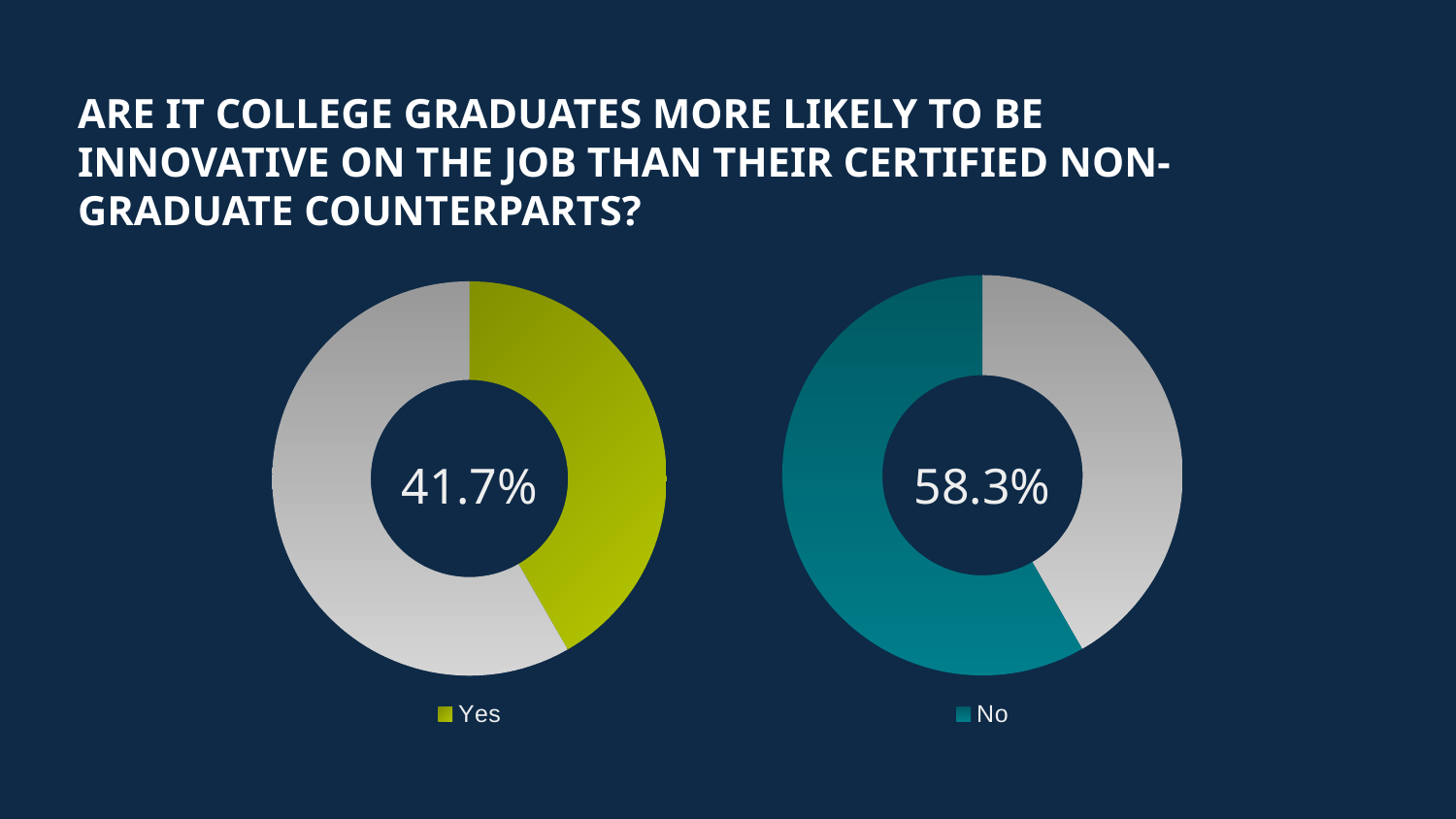
What is the difference in percentage points between the No share (right chart) and the Yes share (left chart)? 16.6 What kind of chart is the right chart? Doughnut chart What kind of chart is the left chart? Doughnut chart Is the No share on the right chart greater or less than 50%? greater How many charts are on the slide? 2 What is the total of the Yes share (left chart) and the No share (right chart)? 100% On the left chart, what percentage is shown for Yes? 41.7% What legend entry is shown under the right chart? No Is the Yes share on the left chart greater or less than 50%? less On the right chart, what percentage is shown for No? 58.3% What legend entry is shown under the left chart? Yes Which response has the larger share, Yes (left chart) or No (right chart)? No